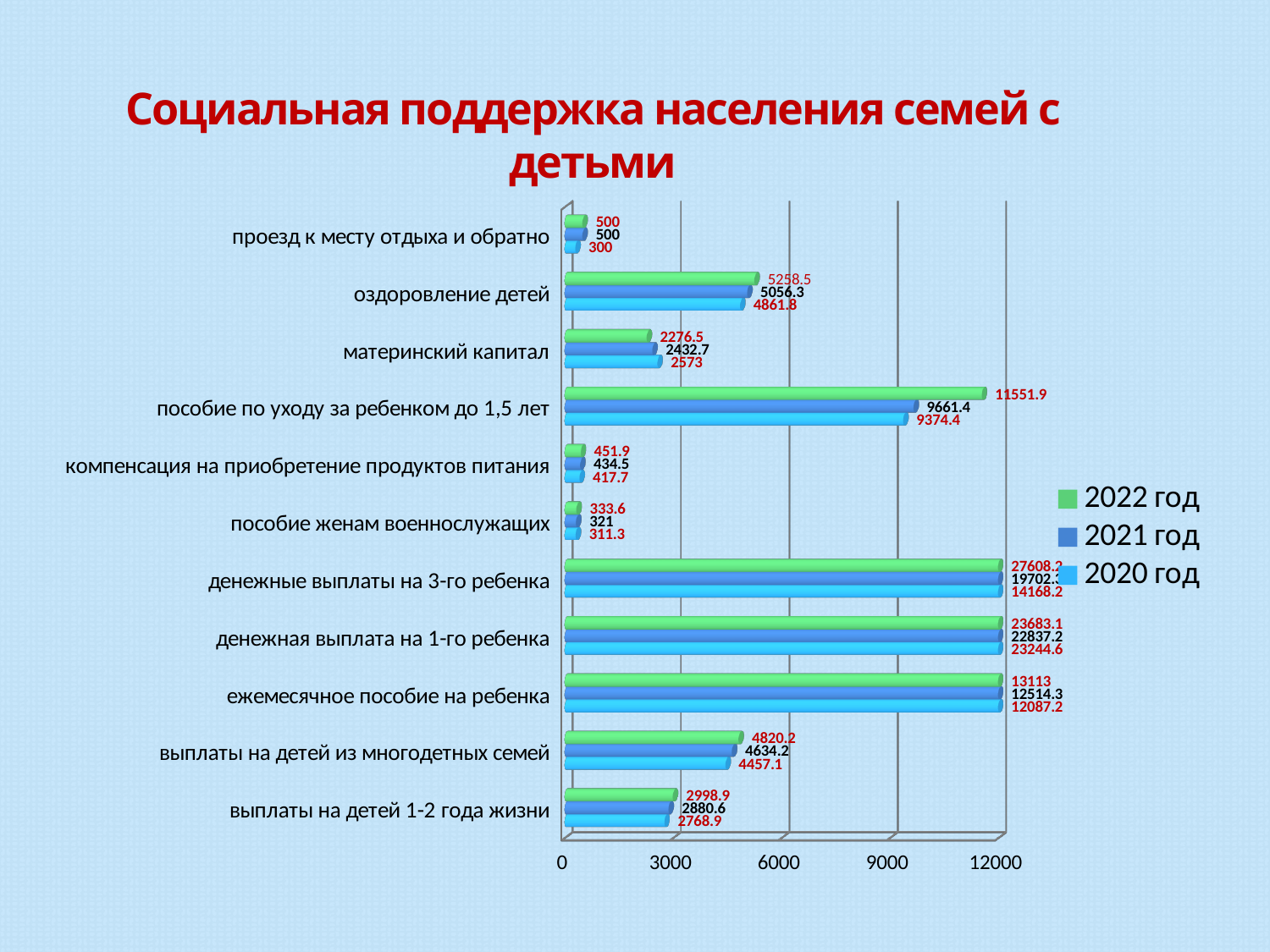
Which series is shown in green in the legend? 2022 год What is the 2020 год value for проезд к месту отдыха и обратно? 300 What is the 2022 год value for пособие по уходу за ребенком до 1,5 лет? 11551.9 Is the 2022 год value for оздоровление детей greater or less than 6000? less What is the 2020 год value for оздоровление детей? 4861.8 How many series does the legend list? 3 What is the 2021 год value for ежемесячное пособие на ребенка? 12514.3 What type of chart is shown on the slide? bar chart How many categories are shown on the chart? 11 What is the difference between the 2022 год and 2021 год values for выплаты на детей из многодетных семей? 186 Which category has the lowest 2022 год value? пособие женам военнослужащих Which is larger for материнский капитал: the 2022 год value or the 2020 год value? 2020 год